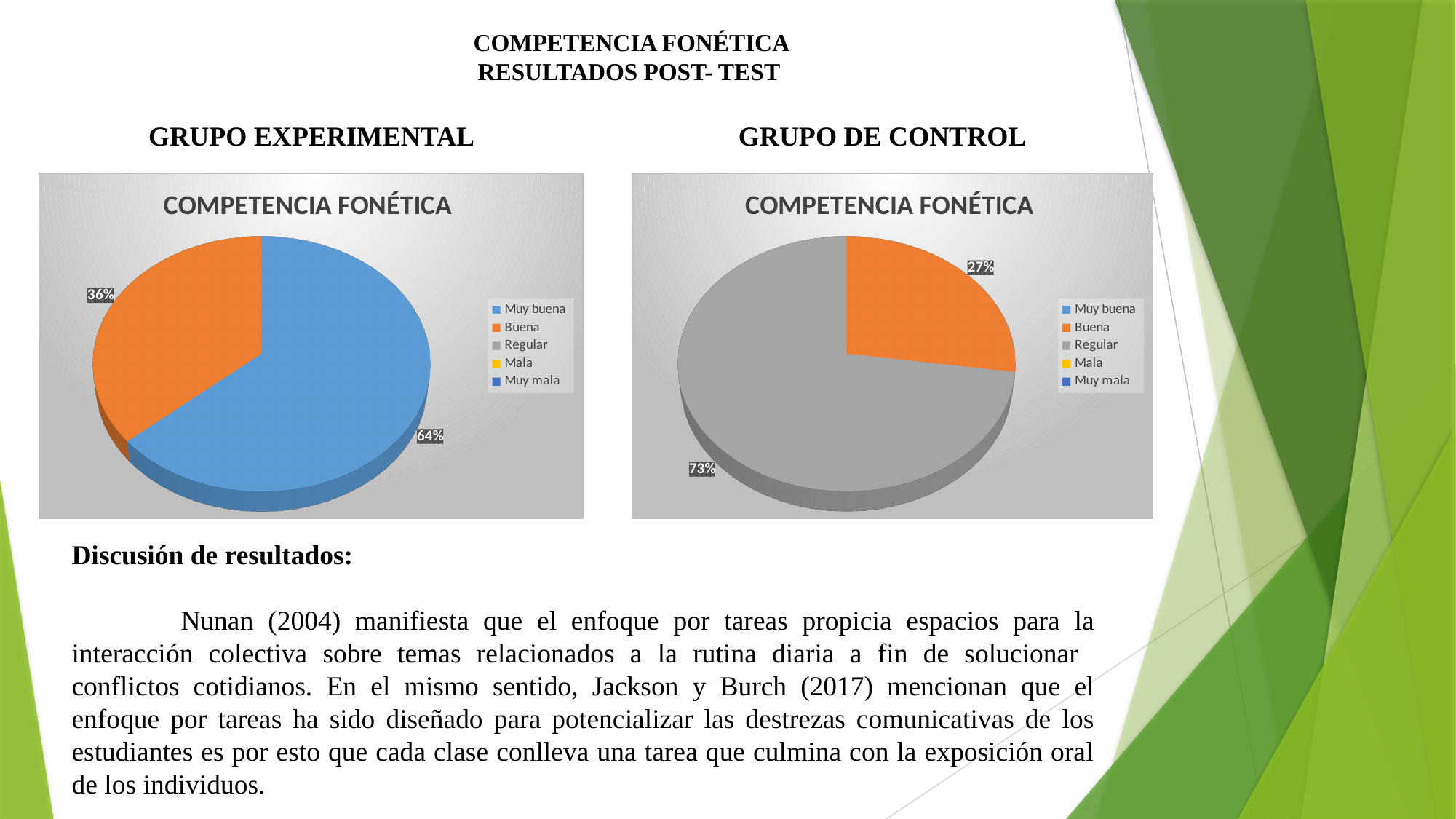
In the GRUPO EXPERIMENTAL chart, which category has the largest slice? Muy buena In the GRUPO DE CONTROL chart, what share of the pie is labelled Regular? 73% How many entries does the legend of the GRUPO DE CONTROL chart list? 5 In the GRUPO DE CONTROL chart, what is the difference between the Regular and Buena percentages? 46% In the GRUPO EXPERIMENTAL chart, what is the difference between the Muy buena and Buena percentages? 28% In the GRUPO EXPERIMENTAL chart, what share of the pie is labelled Muy buena? 64% In the GRUPO EXPERIMENTAL chart, what percentage is shown for Buena? 36% In the GRUPO DE CONTROL chart, which of the two visible slices is the smallest? Buena Which is larger: Buena in the GRUPO EXPERIMENTAL chart or Buena in the GRUPO DE CONTROL chart? GRUPO EXPERIMENTAL In the GRUPO DE CONTROL chart, what percentage is shown for Buena? 27% In the GRUPO DE CONTROL chart, which category has the largest slice? Regular What type of chart is used for the GRUPO EXPERIMENTAL results? Pie chart